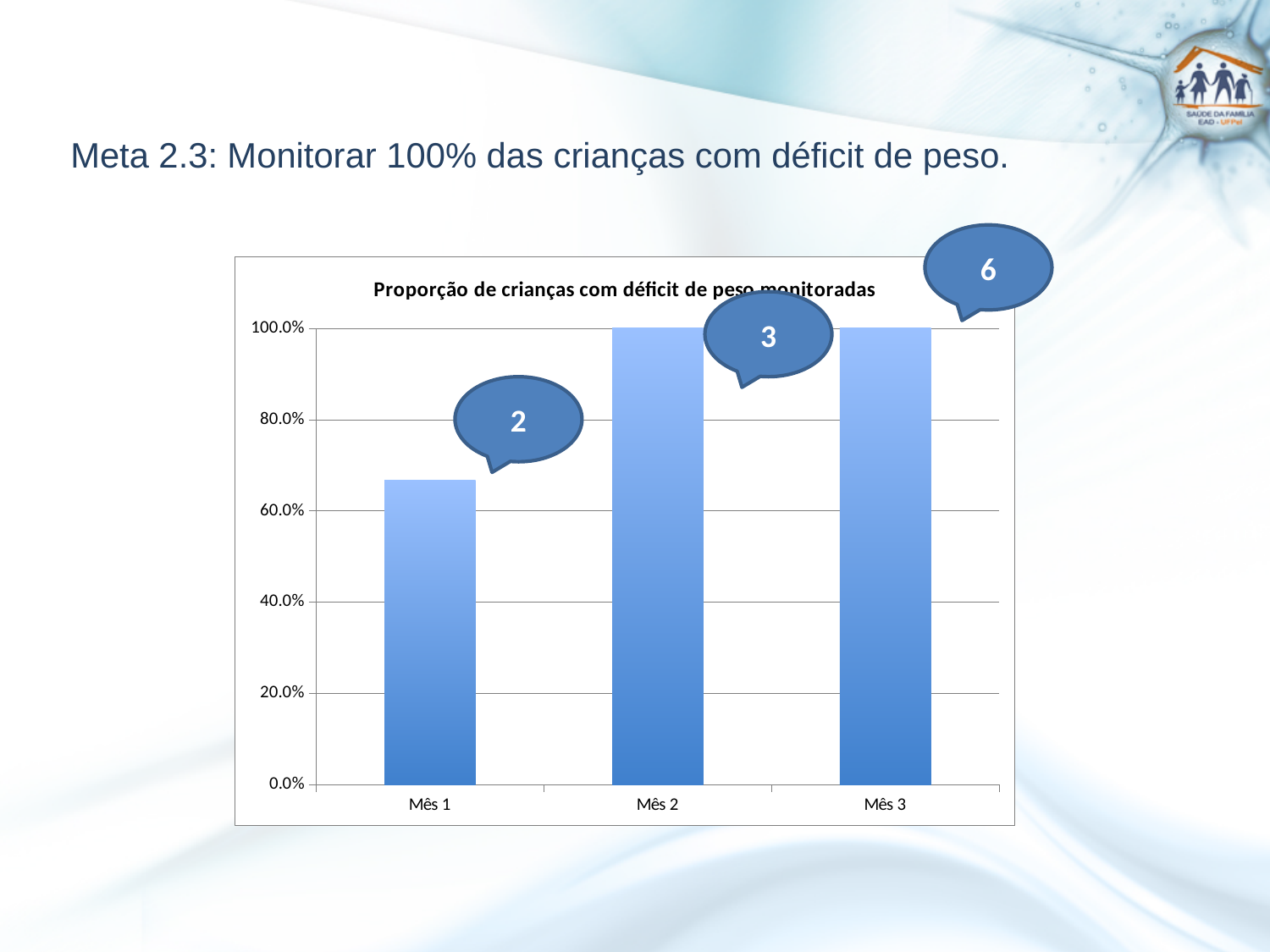
What number is shown in the callout above the Mês 1 bar? 2 How many categories (months) are shown on the x axis of the chart? 3 Is the value for Mês 1 greater or less than 60.0%? greater Which is larger, the value for Mês 1 or the value for Mês 2? Mês 2 What is the value for Mês 2? 100.0% What is the value for Mês 3? 100.0% Do the values rise or fall from Mês 1 to Mês 2? rise Which month has the lowest value? Mês 1 Is the value for Mês 1 greater or less than 80.0%? less What is the title of the chart? Proporção de crianças com déficit de peso monitoradas What type of chart is shown on the slide? bar chart